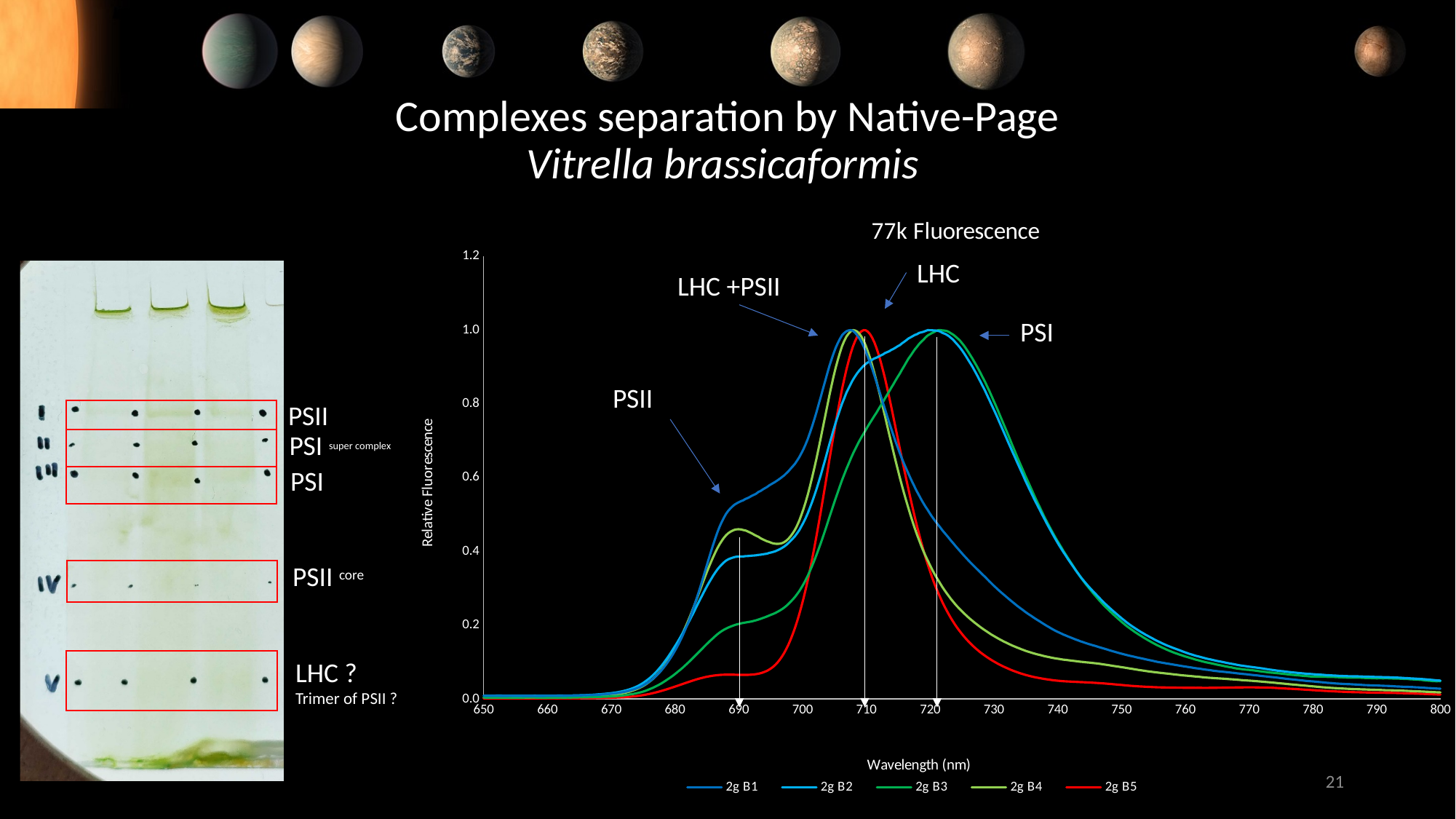
In the "77k Fluorescence" chart, which is larger at 690 nm, the value for 2g B1 or the value for 2g B5? 2g B1 In the "77k Fluorescence" chart, is the value for 2g B5 at 690 nm greater or less than 0.2? less How many tick labels are shown on the x axis of the "77k Fluorescence" chart? 16 What kind of chart is the "77k Fluorescence" chart? line chart How many series does the legend of the "77k Fluorescence" chart list? 5 In the "77k Fluorescence" chart, is the value for 2g B4 at 690 nm greater or less than 0.2? greater In the "77k Fluorescence" chart, which series has the lowest value at 690 nm? 2g B5 In the "77k Fluorescence" chart, do the series rise or fall between 730 nm and 800 nm? fall In the "77k Fluorescence" chart, is the value for 2g B1 at 690 nm greater or less than 0.4? greater What is the label of the x axis of the "77k Fluorescence" chart? Wavelength (nm) What is the title of the chart on the right of the slide? 77k Fluorescence